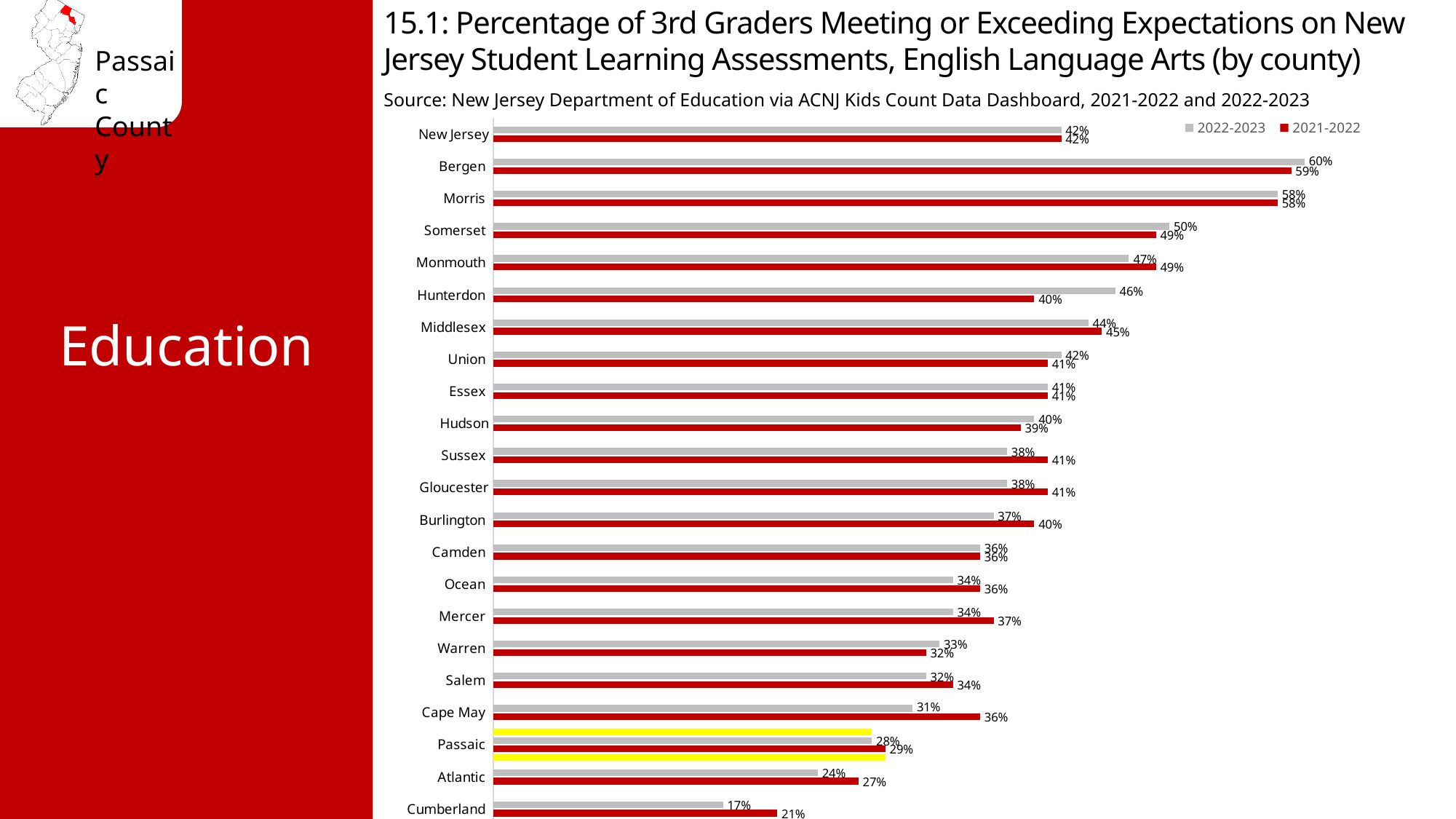
What is the difference between the 2022-2023 and 2021-2022 values for Hunterdon? 6% What is the difference between the 2022-2023 values for Bergen and Cumberland? 43% What is the 2021-2022 value for Hunterdon? 40% Which is larger for Cape May, the 2022-2023 value or the 2021-2022 value? 2021-2022 What is the 2022-2023 value for Cape May? 31% What type of chart is shown on the slide? bar chart What is the 2022-2023 value for Passaic? 28% How many categories (counties plus New Jersey) are shown on the chart? 22 Which county has the highest 2022-2023 value? Bergen Which series is shown in red in the legend? 2021-2022 How many series does the legend list? 2 Which county has the lowest 2021-2022 value? Cumberland